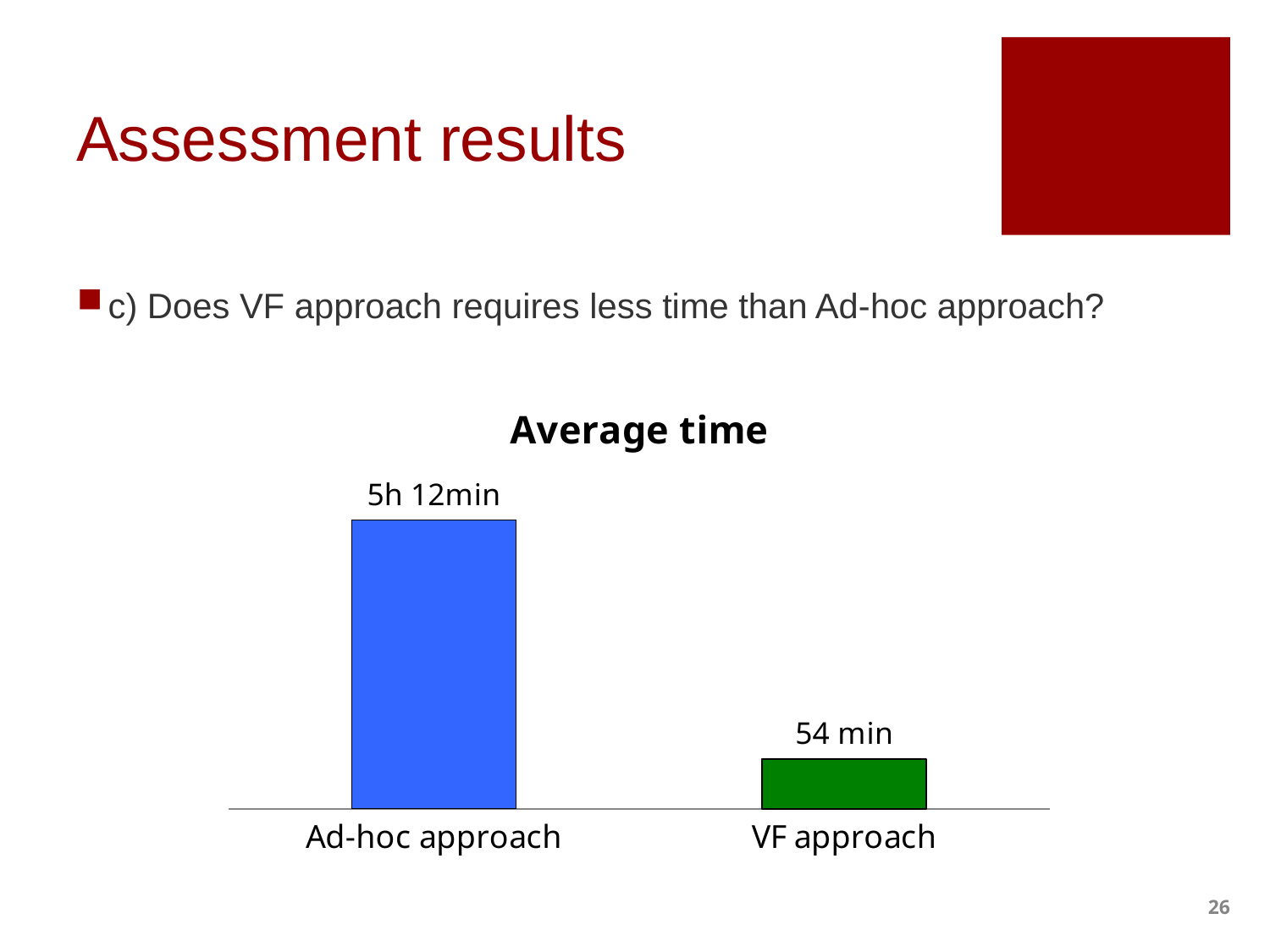
What kind of chart is shown on the slide? Bar chart How many categories are shown in the chart? 2 What colour is the bar for the VF approach? Green What is the average time for the VF approach? 54 min Which approach has the lowest average time? VF approach What is the difference in average time between the Ad-hoc approach and the VF approach? 4h 18min What is the title of the chart? Average time What is the average time for the Ad-hoc approach? 5h 12min Which has a larger average time, the Ad-hoc approach or the VF approach? Ad-hoc approach Which approach has the highest average time? Ad-hoc approach